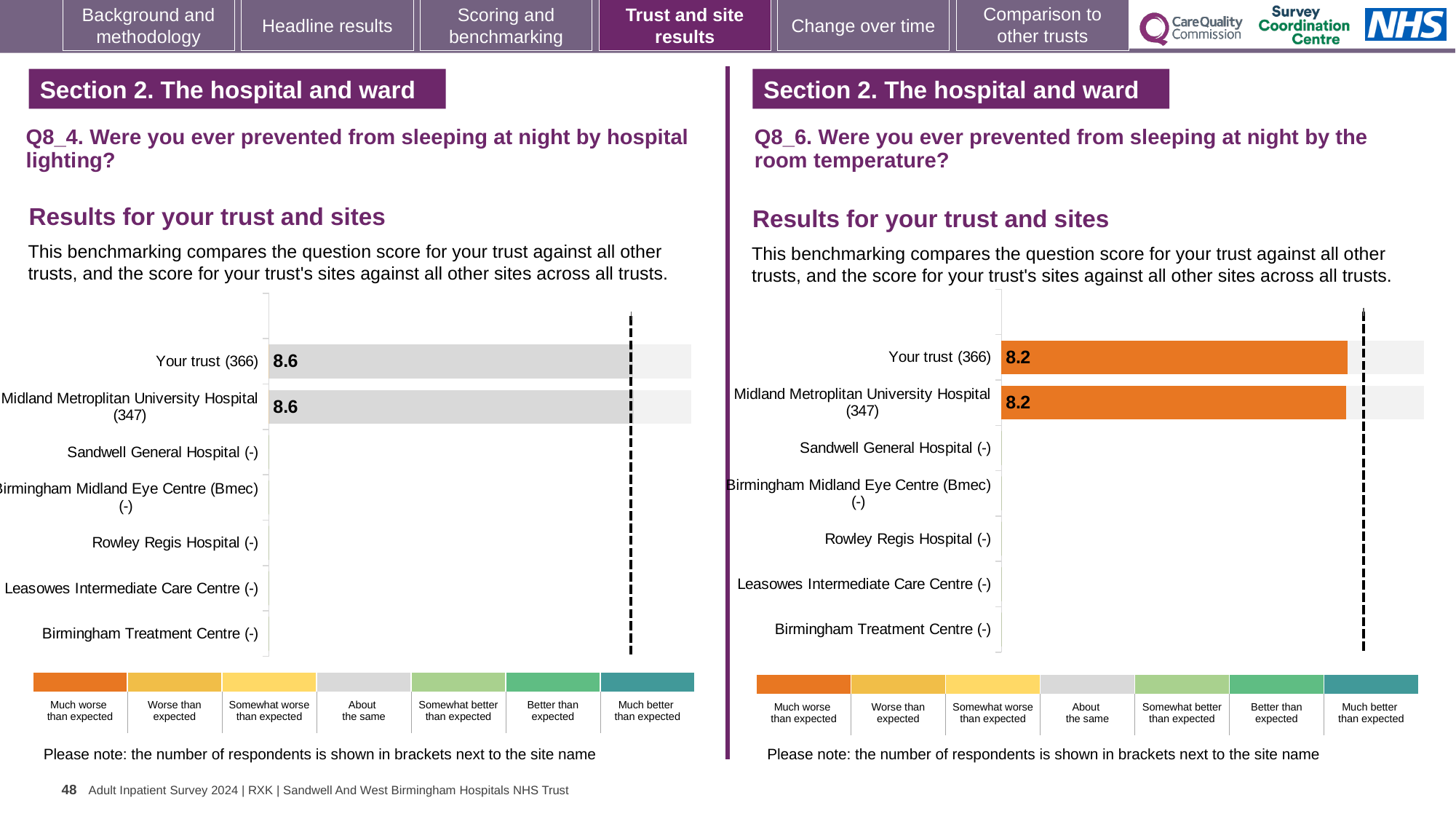
What kind of chart is used on the Q8_6 room temperature chart? Bar chart On the Q8_6 room temperature chart, what is the score for Your trust (366)? 8.2 On the Q8_6 room temperature chart, what is the score for Midland Metroplitan University Hospital (347)? 8.2 On the Q8_4 hospital lighting chart, which benchmark category does the colour of the Your trust bar correspond to in the key? About the same On the Q8_4 hospital lighting chart, how many sites show a plotted bar? 2 On the Q8_6 room temperature chart, which benchmark category does the colour of the Your trust bar correspond to in the key? Much worse than expected On the Q8_4 hospital lighting chart, what is the score for Midland Metroplitan University Hospital (347)? 8.6 What is the difference between the Your trust score on the Q8_4 hospital lighting chart and the Your trust score on the Q8_6 room temperature chart? 0.4 Which is larger: the Your trust score on the Q8_4 hospital lighting chart or the Your trust score on the Q8_6 room temperature chart? Q8_4 hospital lighting How many sites or categories are listed on the Q8_6 room temperature chart? 7 How many sites or categories are listed on the Q8_4 hospital lighting chart? 7 On the Q8_4 hospital lighting chart, what is the score for Your trust (366)? 8.6